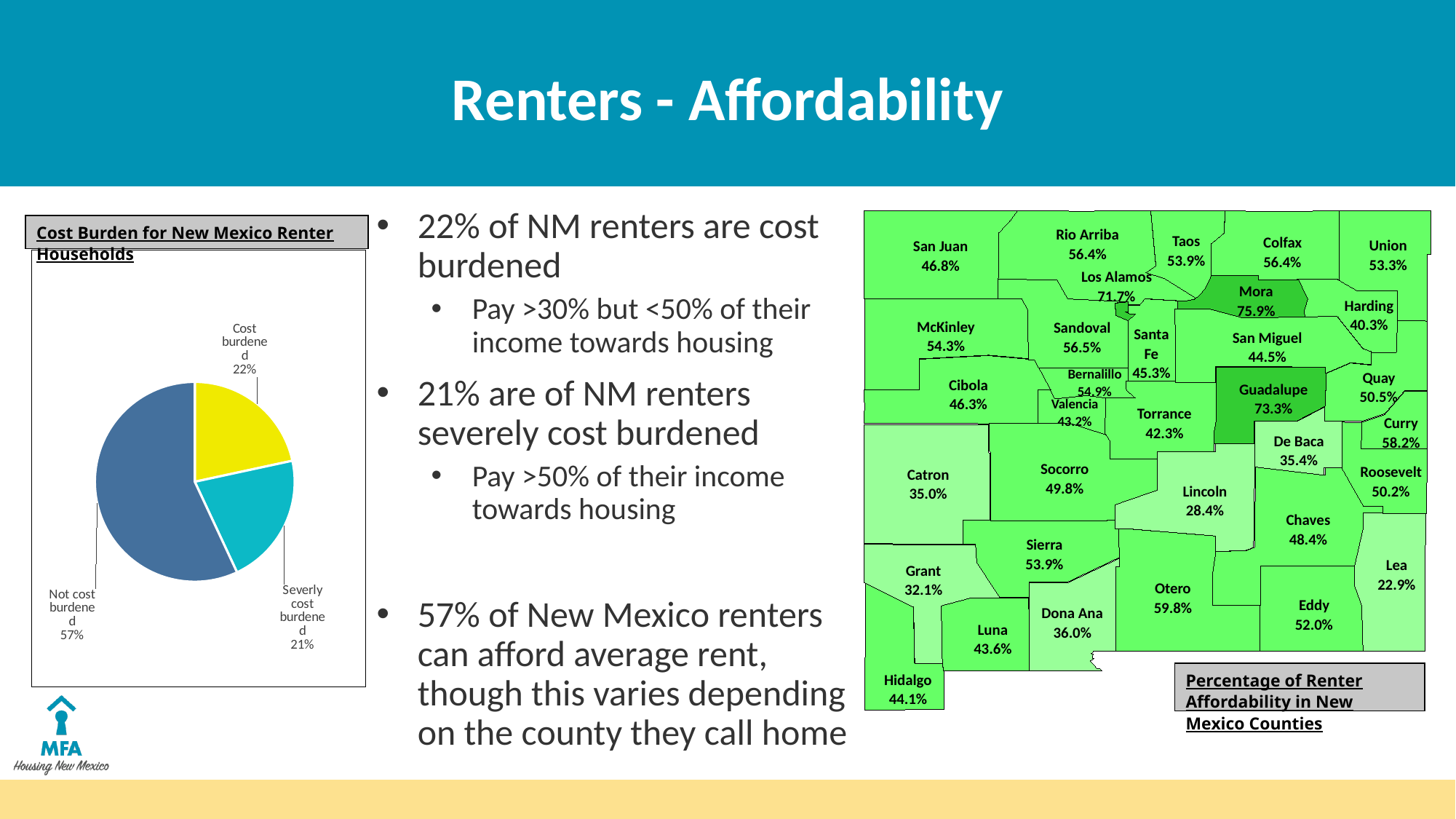
What type of chart is 'Cost Burden for New Mexico Renter Households'? Pie chart In the 'Percentage of Renter Affordability in New Mexico Counties' map, which county has the lowest percentage? Lea In the 'Cost Burden for New Mexico Renter Households' chart, which category has the largest slice? Not cost burdened In the 'Cost Burden for New Mexico Renter Households' chart, which category has the smallest slice? Severely cost burdened In the 'Cost Burden for New Mexico Renter Households' chart, how many slices does the pie have? 3 In the 'Cost Burden for New Mexico Renter Households' chart, what share of renter households are not cost burdened? 57% In the 'Cost Burden for New Mexico Renter Households' chart, what share of renter households are severely cost burdened? 21% In the 'Cost Burden for New Mexico Renter Households' chart, what is the difference in percentage points between the not cost burdened and cost burdened slices? 35 In the 'Cost Burden for New Mexico Renter Households' chart, what colour is the 'Not cost burdened' slice? Blue In the 'Cost Burden for New Mexico Renter Households' chart, what share of renter households are cost burdened? 22% In the 'Percentage of Renter Affordability in New Mexico Counties' map, which county has the highest percentage? Mora In the 'Percentage of Renter Affordability in New Mexico Counties' map, what is the value for Los Alamos? 71.7%